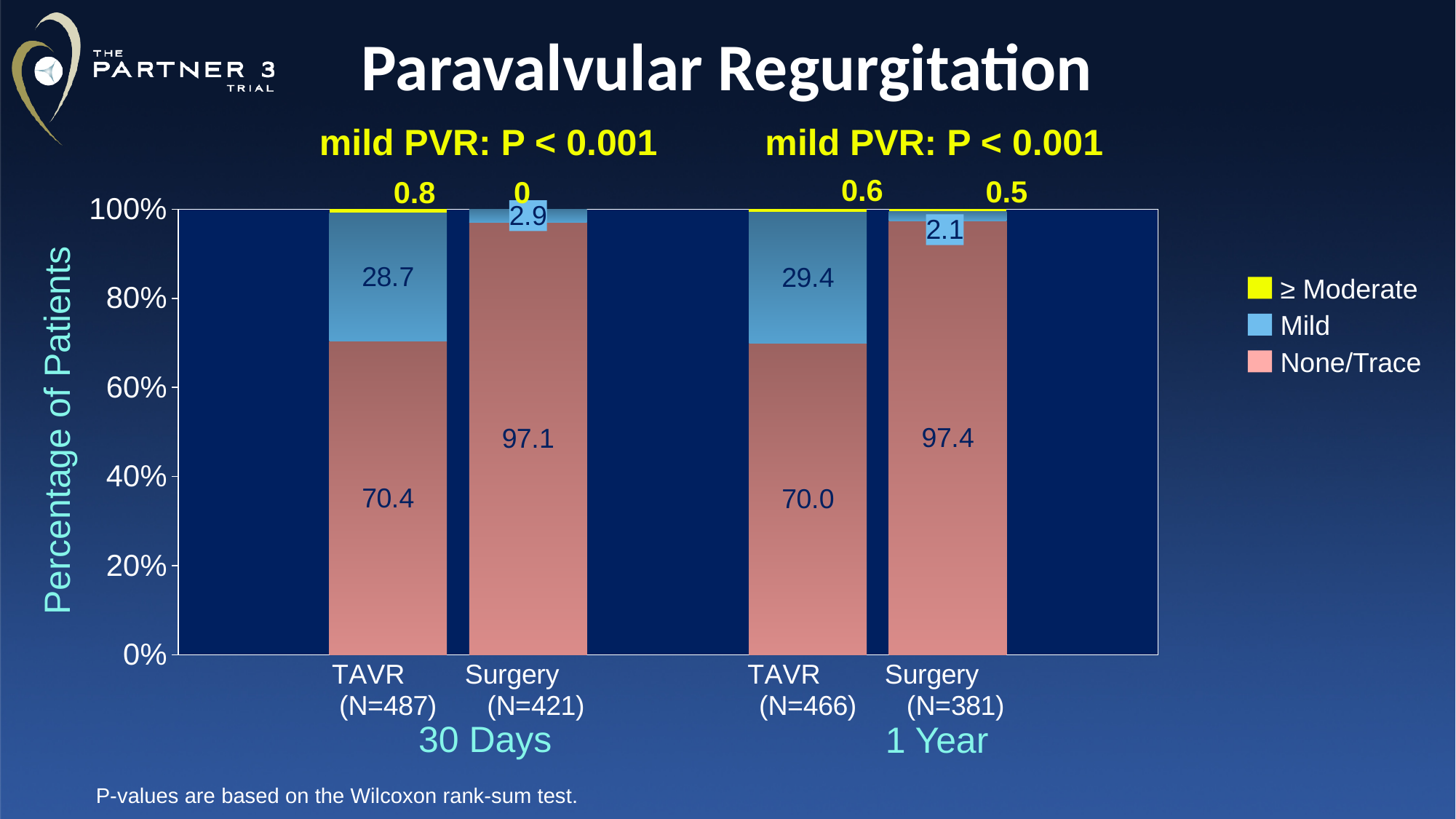
What is the y-axis title of the chart? Percentage of Patients What is the ≥ Moderate value for TAVR (N=466) at 1 Year? 0.6 What is the None/Trace value for TAVR (N=487) at 30 Days? 70.4 Is the Mild value larger for TAVR at 30 Days or TAVR at 1 Year? TAVR at 1 Year Which bar has the lowest ≥ Moderate value? Surgery (N=421) at 30 Days What is the Mild value for Surgery (N=421) at 30 Days? 2.9 How many bars are plotted in the chart? 4 Which bar has the highest Mild value? TAVR (N=466) at 1 Year How many series does the legend list? 3 What is the difference between the None/Trace values for Surgery and TAVR at 30 Days? 26.7 What is the None/Trace value for Surgery (N=381) at 1 Year? 97.4 What kind of chart is shown on the slide? Stacked bar chart